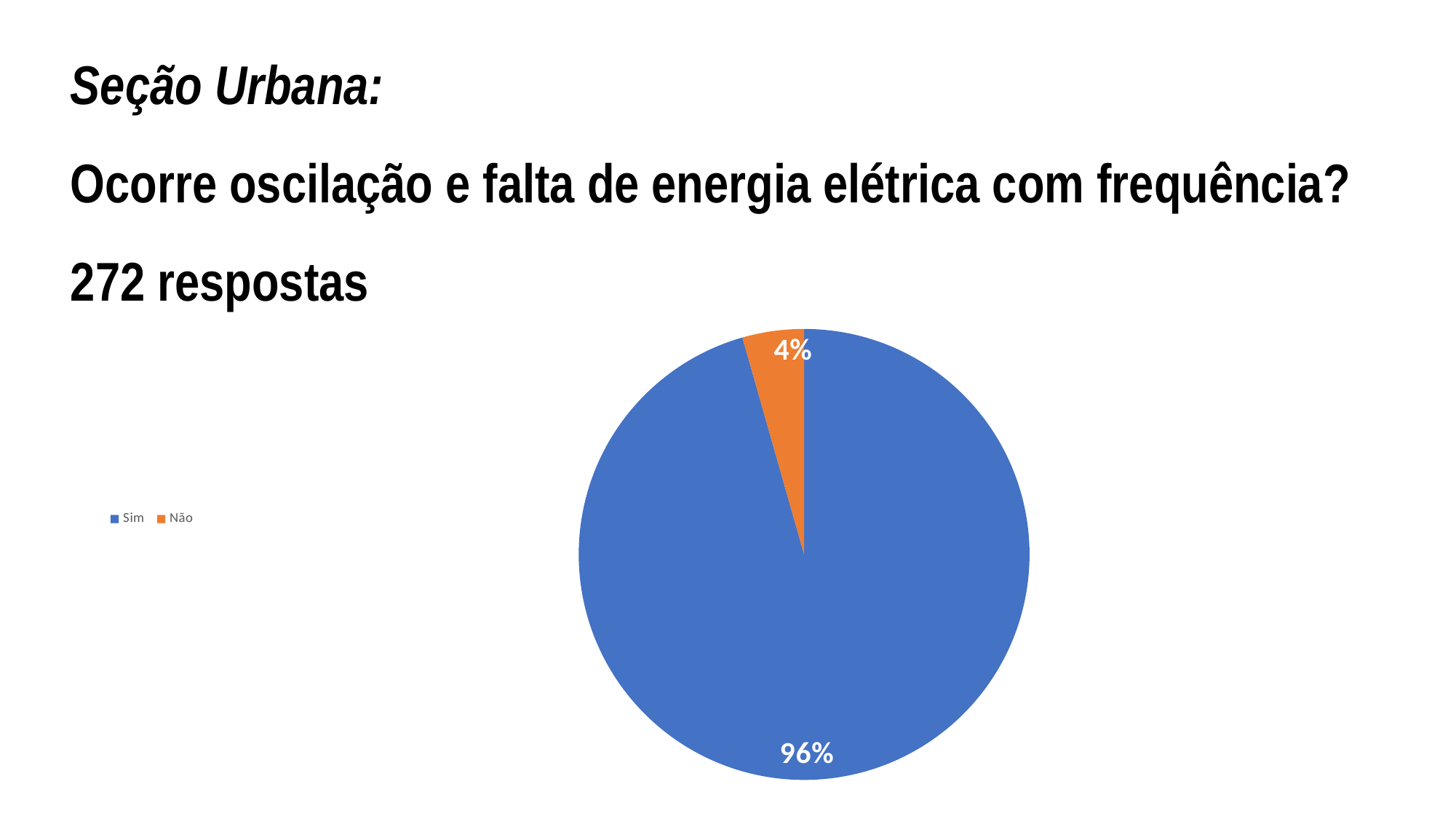
Which category has the smallest slice of the pie? Não Which is larger, the "Sim" slice or the "Não" slice? Sim Which category has the largest slice of the pie? Sim What share of the pie does the "Sim" slice represent? 96% How many categories are shown in the pie chart? 2 What share of the pie does the "Não" slice represent? 4% What kind of chart is shown on the slide? Pie chart How many entries does the legend list? 2 How many responses does the slide say the chart is based on? 272 respostas What is the difference in percentage points between the "Sim" and "Não" slices? 92 What colour is the "Não" slice? Orange